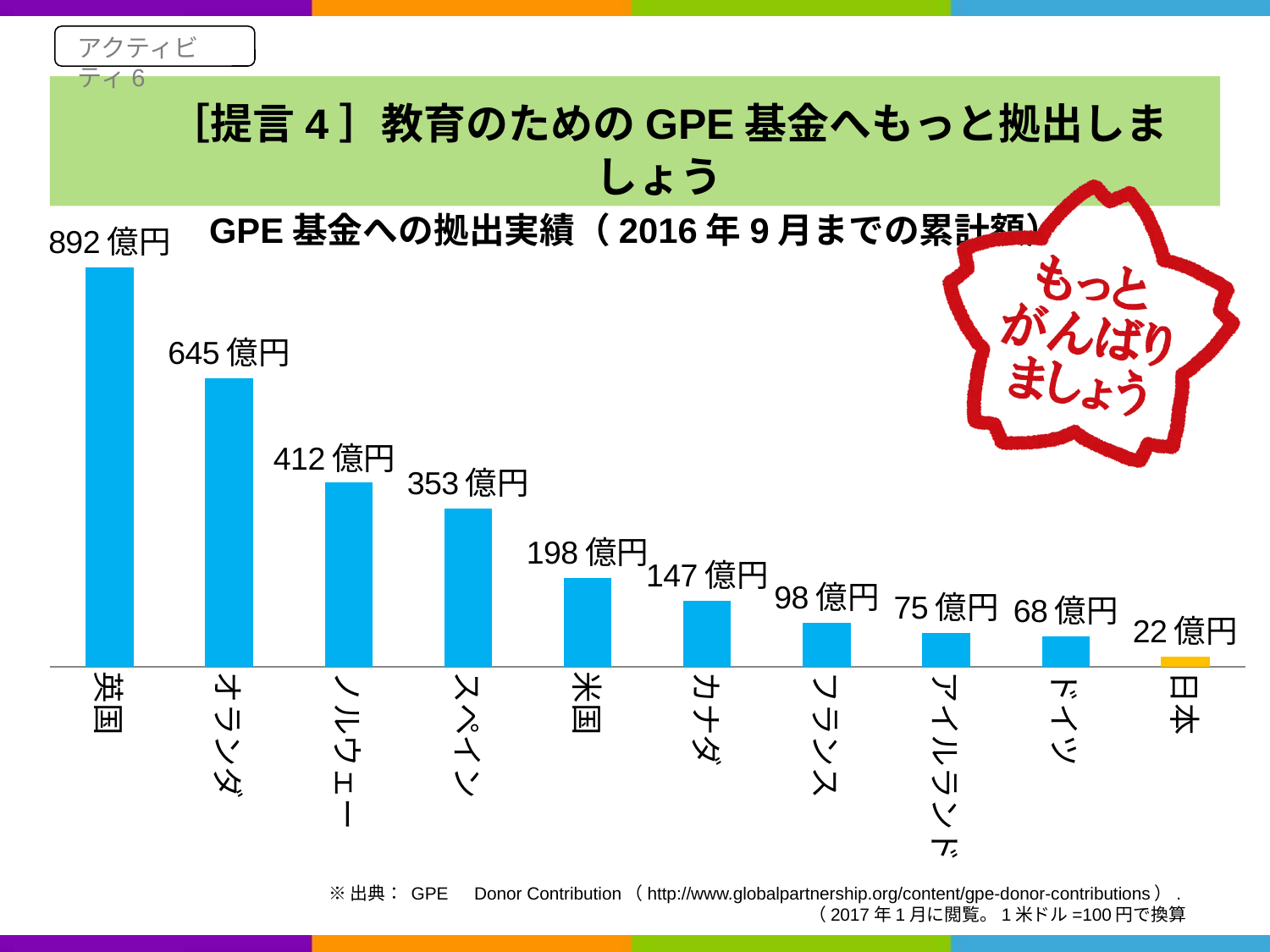
What is the difference between the values for 英国 and 日本? 870 億円 What is the value shown for 米国 (USA)? 198 億円 Which country has the lowest contribution in the chart? 日本 Which country has the highest contribution in the chart? 英国 What is the value shown for 日本 (Japan)? 22 億円 Which is larger, the value for カナダ or the value for フランス? カナダ How many countries are shown in the chart? 10 Do the values rise or fall from left to right along the x axis? fall What is the value shown for 英国 (UK)? 892 億円 What kind of chart is shown on the slide? bar chart Which bar is shown in a different colour (orange) from the others? 日本 What is the difference between the values for オランダ and ノルウェー? 233 億円